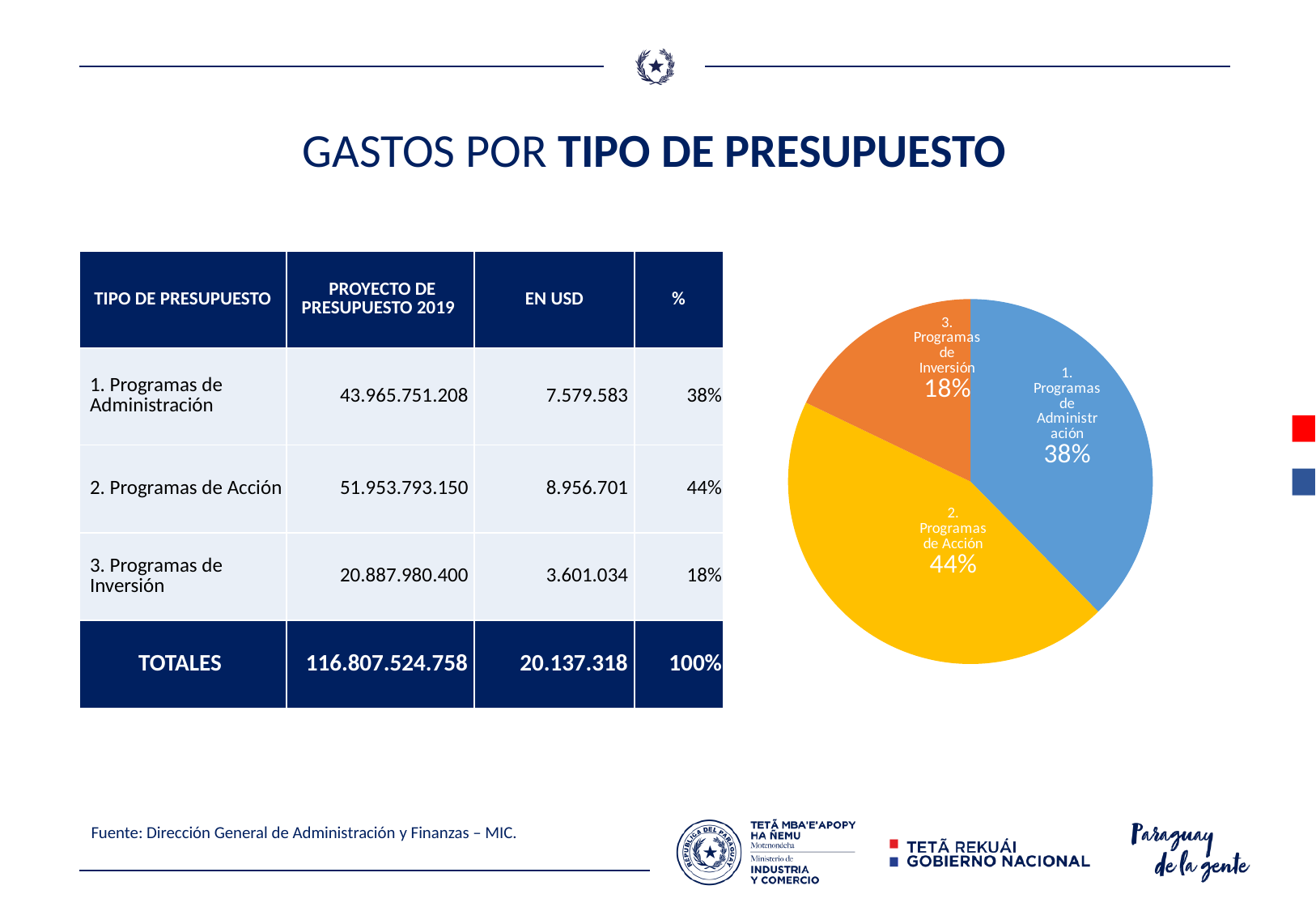
What type of chart is shown on the slide? pie chart Which slice of the pie chart is the largest? 2. Programas de Acción What is the difference in percentage points between the '2. Programas de Acción' slice and the '3. Programas de Inversión' slice? 26 What share of the pie does '3. Programas de Inversión' represent? 18% What is the difference in percentage points between the '1. Programas de Administración' slice and the '3. Programas de Inversión' slice? 20 What colour is the '3. Programas de Inversión' slice in the pie chart? orange Which is larger in the pie chart: '1. Programas de Administración' or '2. Programas de Acción'? 2. Programas de Acción What share of the pie does '1. Programas de Administración' represent? 38% How many slices does the pie chart have? 3 Which slice of the pie chart is the smallest? 3. Programas de Inversión What colour is the '2. Programas de Acción' slice in the pie chart? yellow What share of the pie does '2. Programas de Acción' represent? 44%